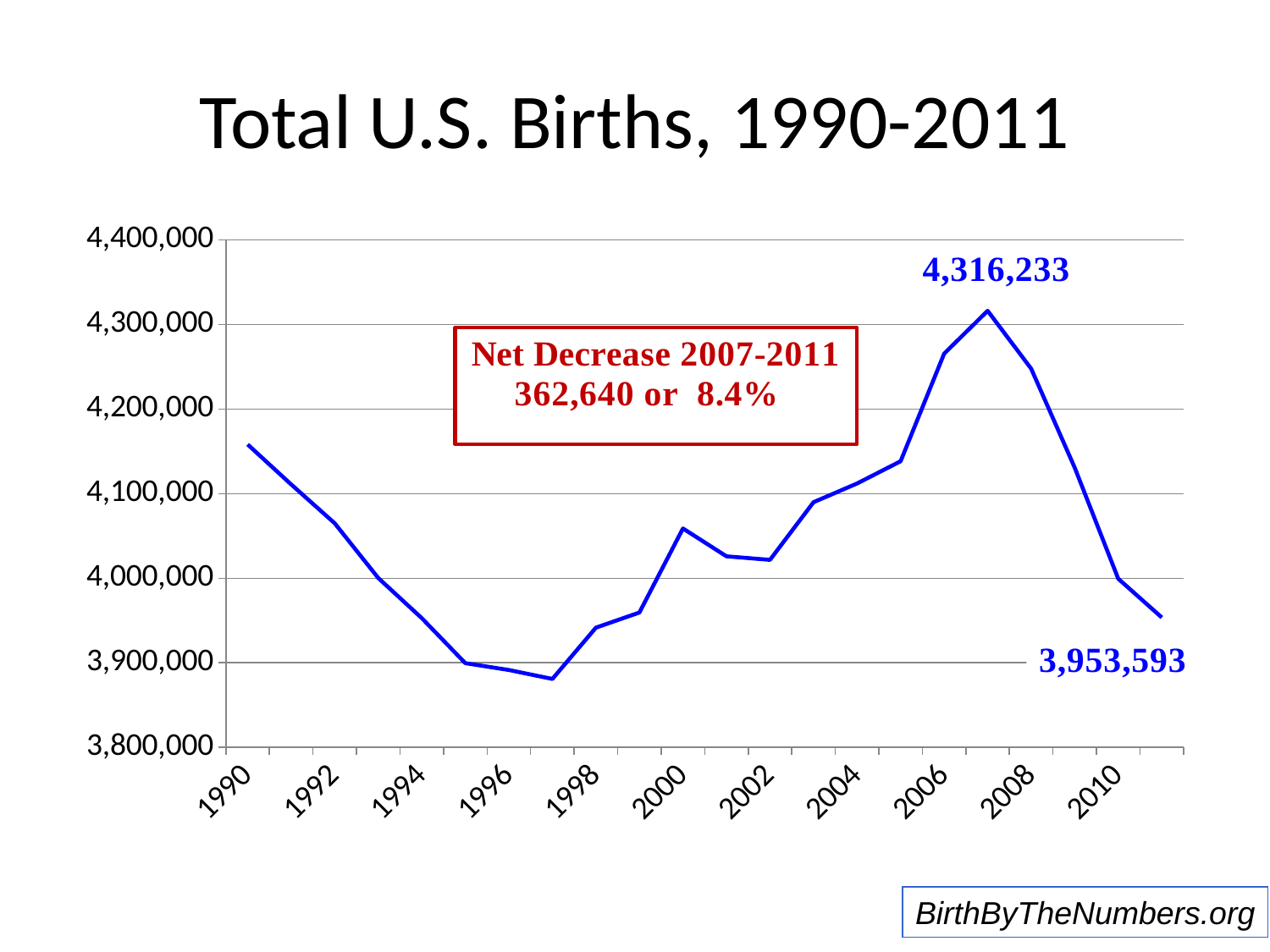
Is the value for 1990 greater or less than 4,100,000? greater What kind of chart is shown on the slide? Line chart Which year had more births, 1990 or 2011? 1990 What is the labelled peak value of total U.S. births in 2007? 4,316,233 Is the value for 1997 greater or less than 3,900,000? less What is the title of the chart? Total U.S. Births, 1990-2011 What is the net decrease in births from 2007 to 2011, as shown on the slide? 362,640 or 8.4% Do total births rise or fall from 2007 to 2011? Fall In which year were total U.S. births highest? 2007 What is the labelled value of total U.S. births in 2011? 3,953,593 Is the value for 2000 greater or less than 4,000,000? greater How many years (data points) are plotted on the chart? 22